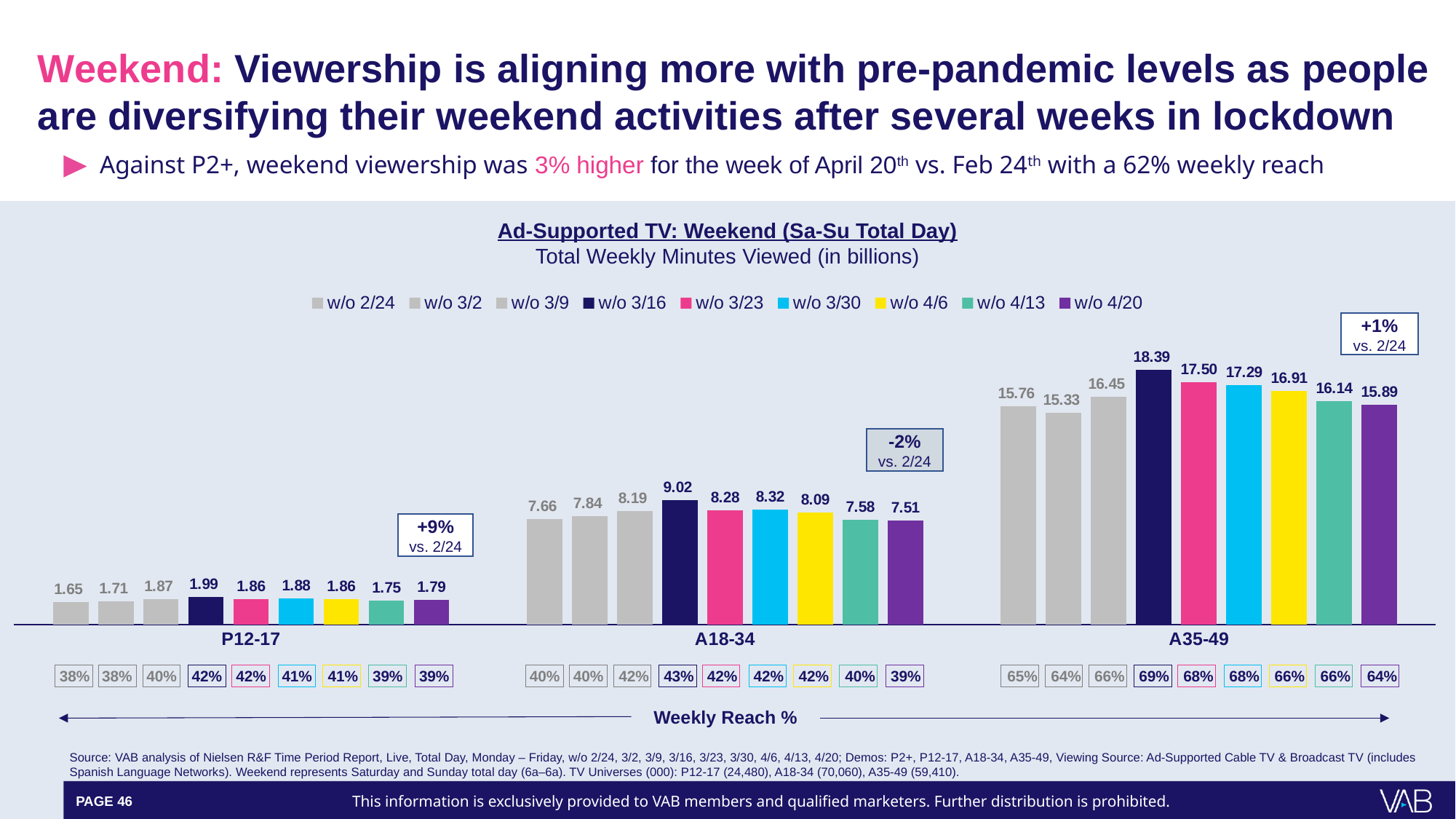
What kind of chart is shown on the slide? bar chart Which week has the highest value for A35-49? w/o 3/16 What is the difference between the A35-49 values for w/o 3/16 and w/o 2/24? 2.63 What is the value for A35-49 in the week of 4/20? 15.89 What is the title of the chart? Ad-Supported TV: Weekend (Sa-Su Total Day) What is the value for P12-17 in the week of 3/16? 1.99 Which week has the lowest value for P12-17? w/o 2/24 How many series does the legend list? 9 For A18-34, do the values rise or fall from w/o 3/30 to w/o 4/20? fall What is the total weekly minutes viewed (in billions) for A18-34 in the week of 3/16? 9.02 How many demographic groups are shown on the x axis? 3 For A18-34, which is larger: the value for w/o 3/23 or w/o 3/30? w/o 3/30